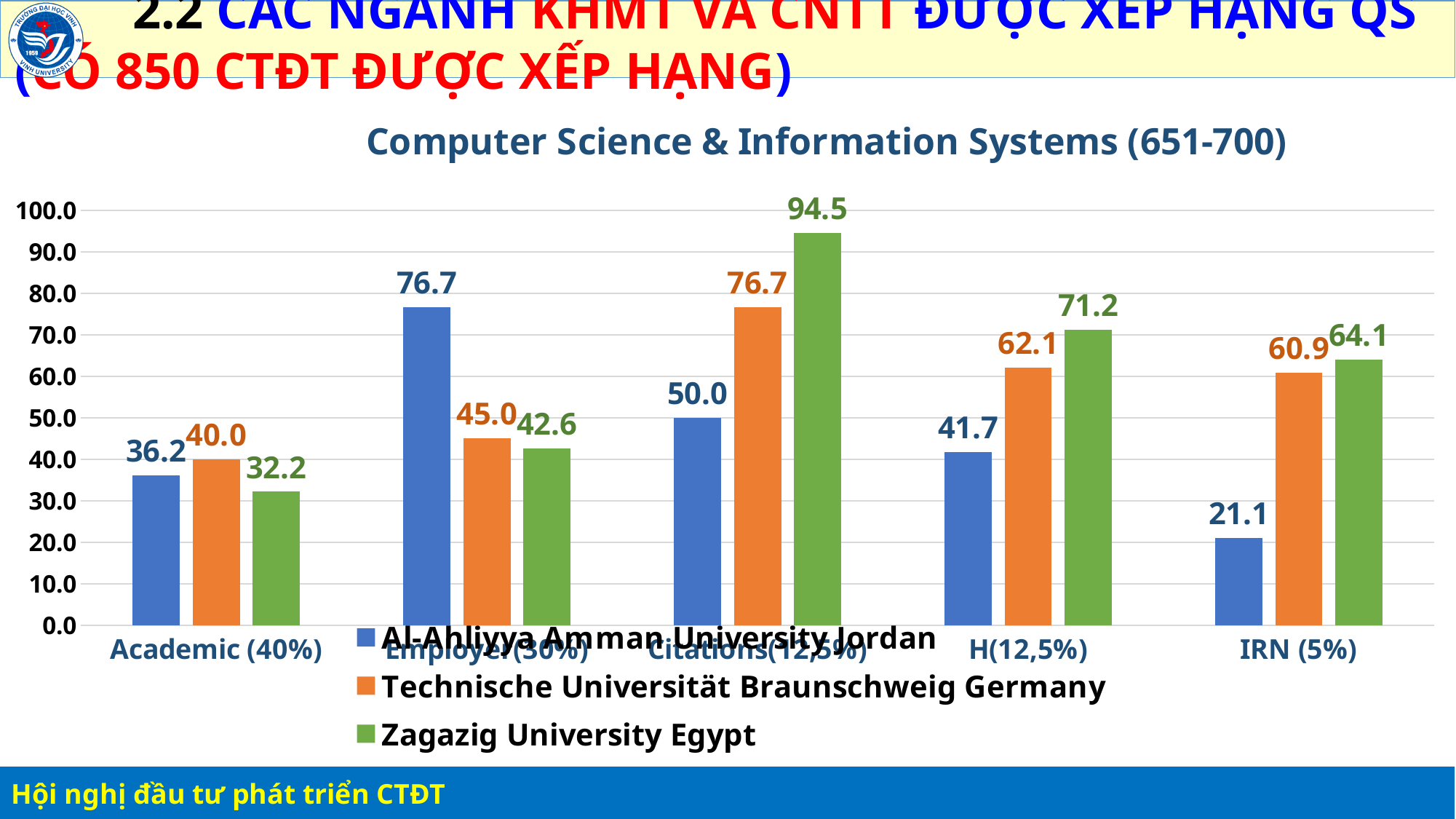
How many categories are shown on the x axis? 5 What kind of chart is shown on the slide? Bar chart What is the value for Technische Universität Braunschweig Germany in the H(12,5%) category? 62.1 How many series does the legend list? 3 Which university has the highest value in the Citations(12,5%) category? Zagazig University Egypt Is the value for Zagazig University Egypt in the Citations(12,5%) category greater or less than 90.0? greater What is the value for Zagazig University Egypt in the Academic (40%) category? 32.2 What is the title of the chart? Computer Science & Information Systems (651-700) Which university has the lowest value in the IRN (5%) category? Al-Ahliyya Amman University Jordan What is the difference between Zagazig University Egypt and Al-Ahliyya Amman University Jordan in the H(12,5%) category? 29.5 What is the value for Al-Ahliyya Amman University Jordan in the IRN (5%) category? 21.1 Which is larger in the Academic (40%) category: Al-Ahliyya Amman University Jordan or Technische Universität Braunschweig Germany? Technische Universität Braunschweig Germany